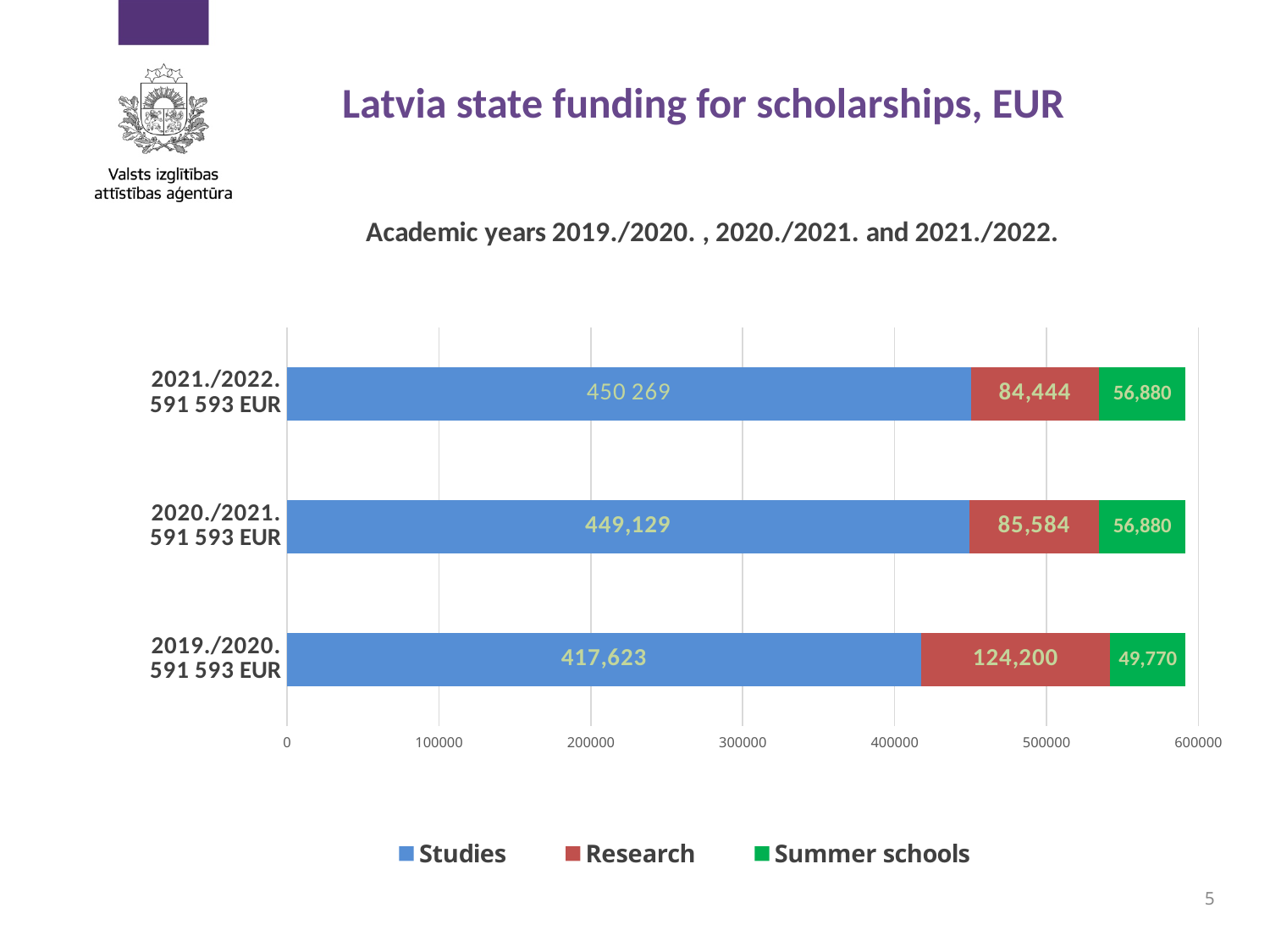
Which academic year has the lowest Studies value? 2019./2020. What is the value for Studies in 2019./2020.? 417,623 What kind of chart is shown on the slide? stacked bar chart How many academic years are shown on the chart? 3 How many series does the legend list? 3 What is the difference between the Research value in 2019./2020. and in 2020./2021.? 38,616 What is the value for Summer schools in 2019./2020.? 49,770 What is the total of the stacked bar for 2019./2020.? 591 593 EUR What is the value for Research in 2021./2022.? 84,444 Which academic year has the highest Research value? 2019./2020. Is the Studies value for 2019./2020. greater or less than 400000? greater Which is larger, the Studies value in 2021./2022. or in 2020./2021.? 2021./2022.